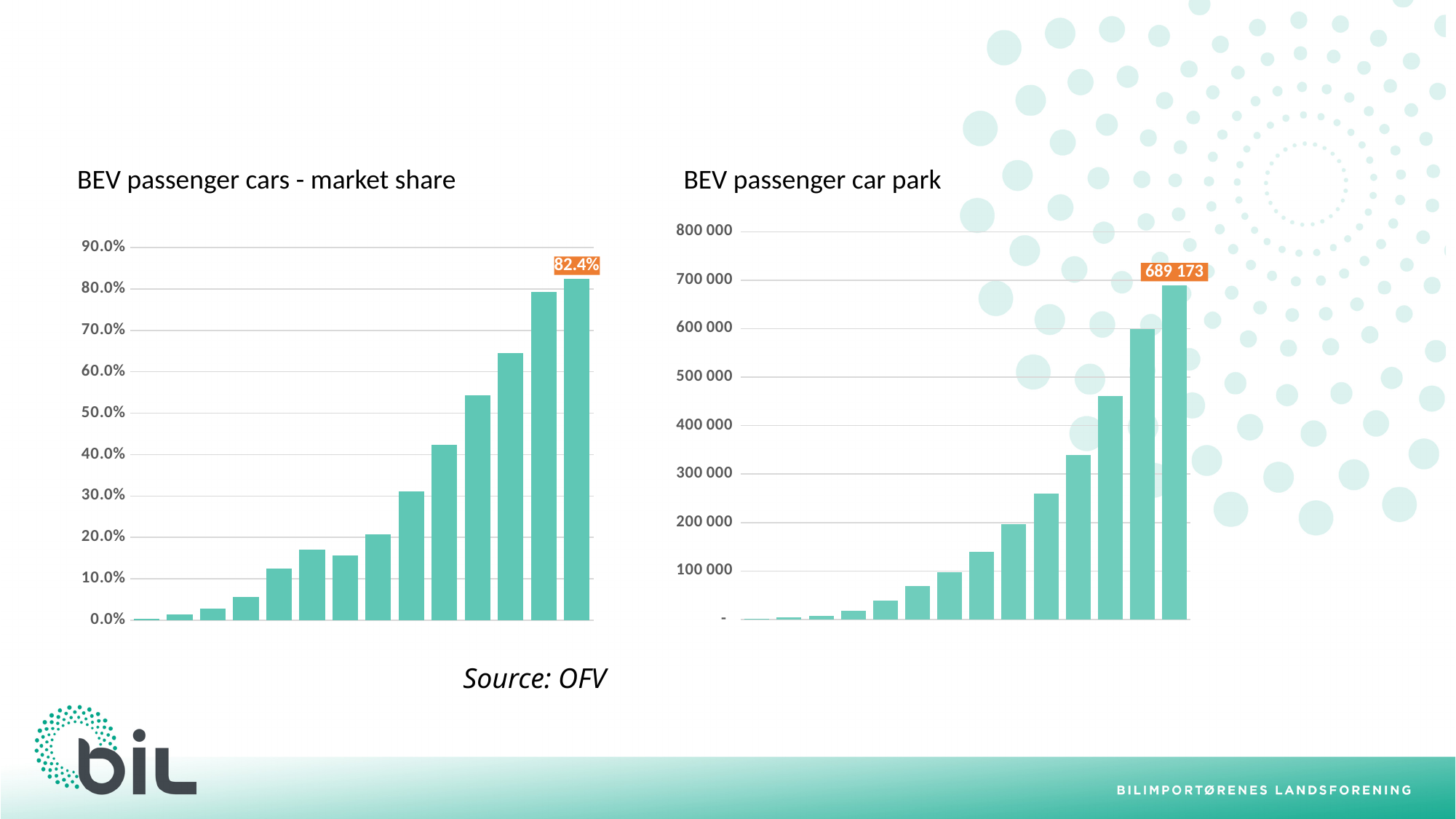
In the 'BEV passenger car park' chart, which bar is the highest? the last (rightmost) bar, 689 173 How many bars are plotted in the 'BEV passenger cars - market share' chart? 14 What kind of chart is the 'BEV passenger cars - market share' chart? bar chart What kind of chart is the 'BEV passenger car park' chart? bar chart In the 'BEV passenger car park' chart, what value is printed on the last (rightmost) bar? 689 173 In the 'BEV passenger cars - market share' chart, is the value of the second-to-last bar greater or less than 70.0%? greater In the 'BEV passenger car park' chart, do the values rise or fall from left to right? rise What source is cited for the charts on the slide? OFV In the 'BEV passenger cars - market share' chart, do the values generally rise or fall from left to right? rise In the 'BEV passenger car park' chart, is the value of the third-to-last bar greater or less than 500 000? less How many bars are plotted in the 'BEV passenger car park' chart? 14 In the 'BEV passenger cars - market share' chart, what value is printed on the last (rightmost) bar? 82.4%